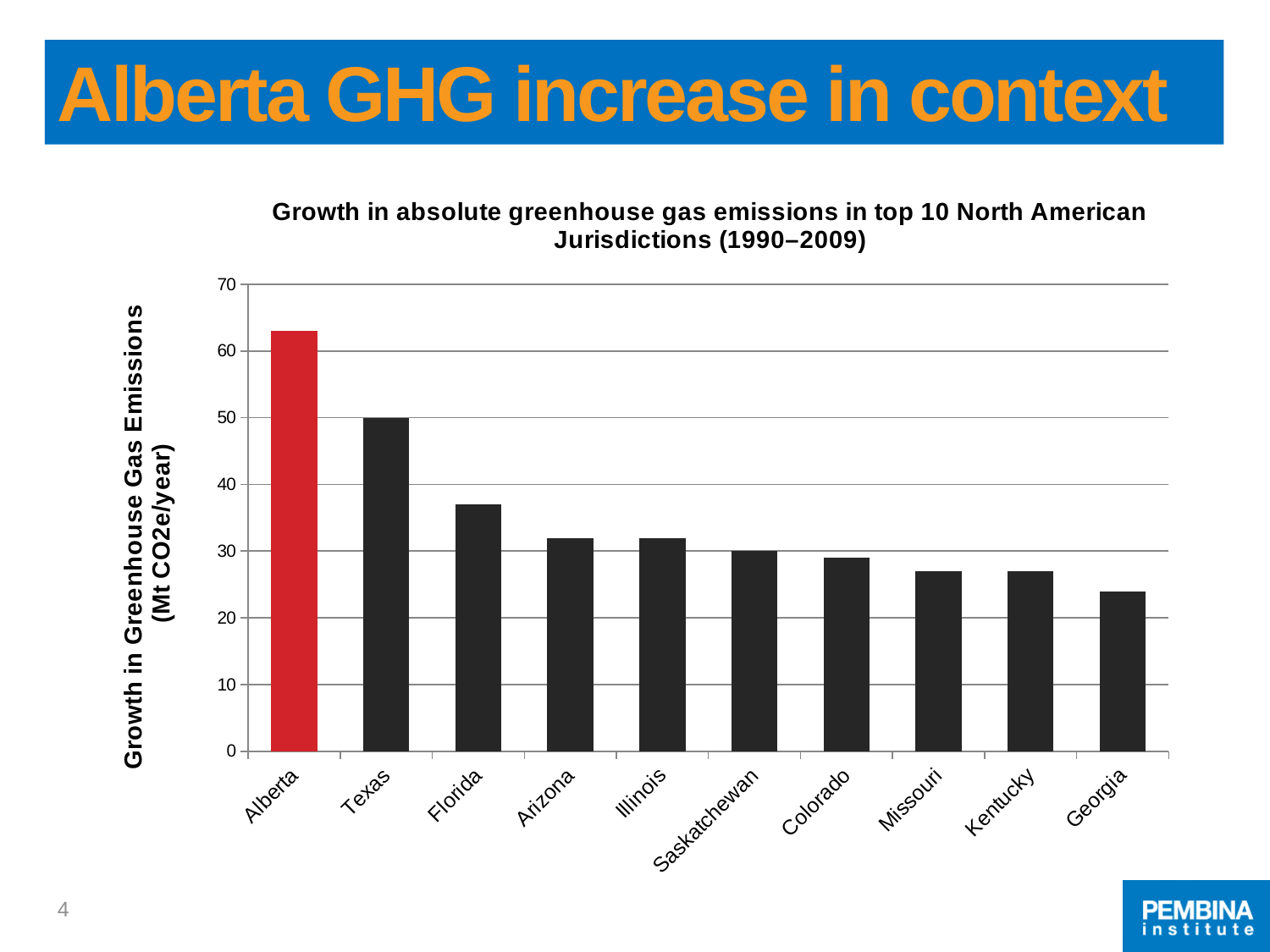
Do the values rise or fall moving from left to right along the x axis? fall What is the title of the chart? Growth in absolute greenhouse gas emissions in top 10 North American Jurisdictions (1990–2009) Is the value for Alberta greater or less than 60? greater Which has the larger growth in greenhouse gas emissions, Alberta or Texas? Alberta Is the value for Florida greater or less than 40? less Is the value for Georgia greater or less than 20? greater How many jurisdictions are shown on the x axis of the chart? 10 What kind of chart is shown on the slide? Bar chart Which jurisdiction has the highest growth in greenhouse gas emissions? Alberta Which jurisdiction has the lowest growth in greenhouse gas emissions? Georgia Which has the larger growth in greenhouse gas emissions, Florida or Georgia? Florida What colour is the bar for Alberta? Red